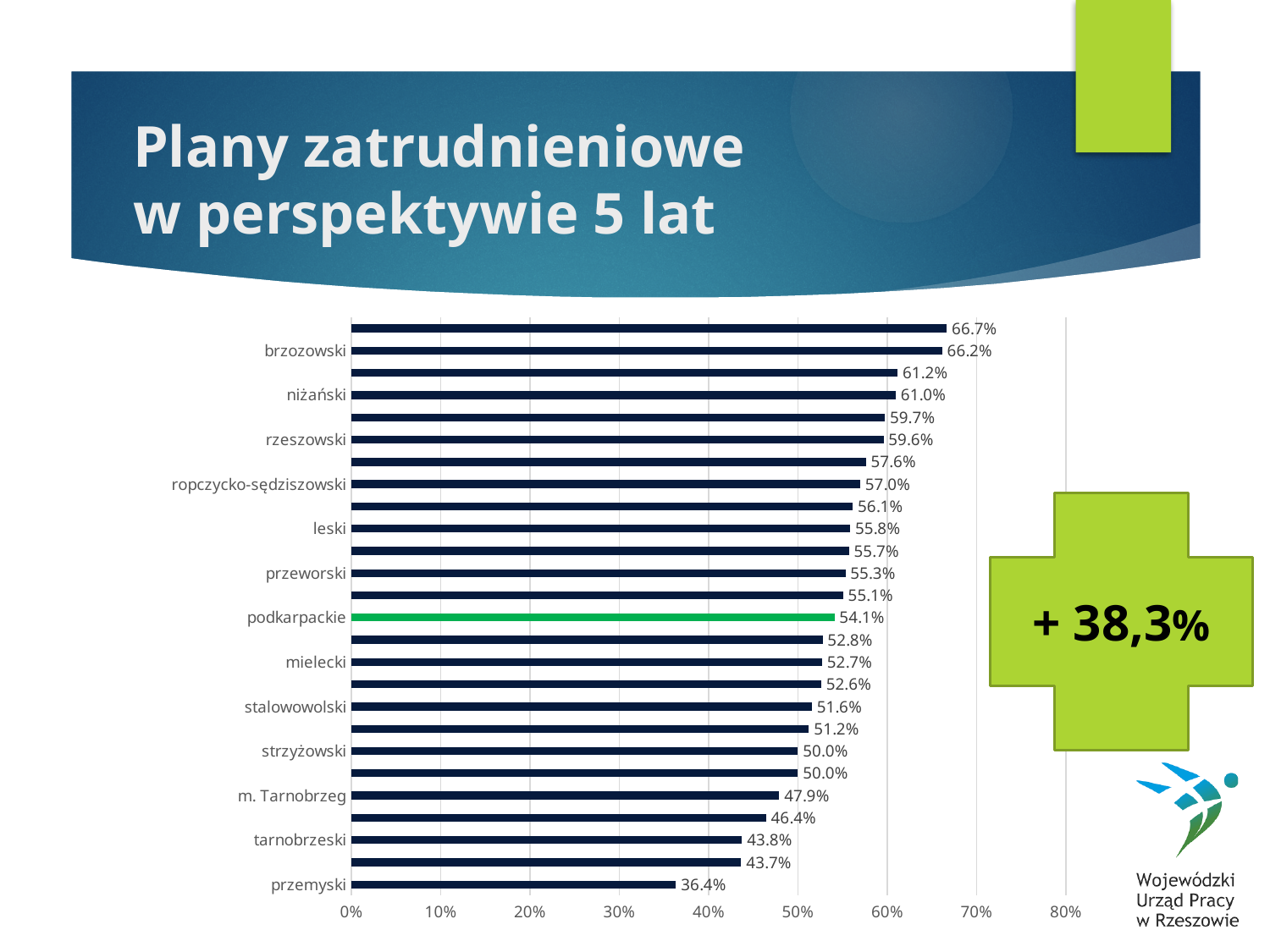
How many bars are plotted in the chart? 26 Which has a higher value, niżański or rzeszowski? niżański What is the value for przemyski? 36.4% What is the difference between the values for brzozowski and przemyski? 29.8 percentage points Which category's bar is coloured green instead of dark blue? podkarpackie What is the value for podkarpackie? 54.1% What is the difference between the values for podkarpackie and mielecki? 1.4 percentage points Is the value for tarnobrzeski greater or less than 50%? less What is the value for m. Tarnobrzeg? 47.9% Which labelled category has the lowest value? przemyski What kind of chart is shown on the slide? bar chart What is the value for brzozowski? 66.2%